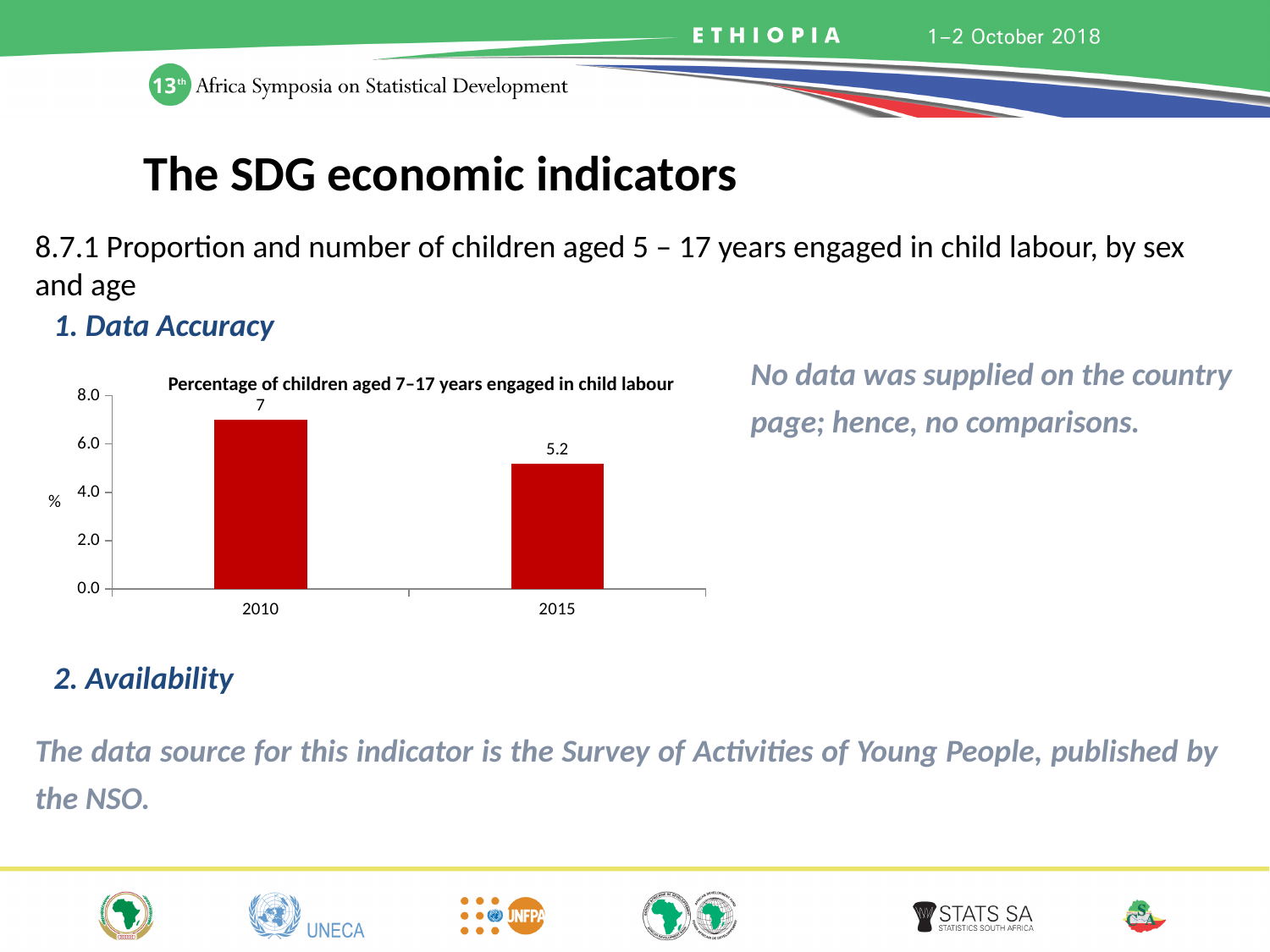
What is the value for 2015? 5.2 Is the value for 2010 greater or less than 6.0? greater Which year has the highest percentage of children engaged in child labour? 2010 Do the values rise or fall from 2010 to 2015? fall What is the title of the chart? Percentage of children aged 7–17 years engaged in child labour What is the difference between the values for 2010 and 2015? 1.8 Which is larger, the value for 2010 or the value for 2015? 2010 What is the value for 2010? 7 Is the value for 2015 greater or less than 6.0? less How many years are shown on the x axis? 2 What kind of chart is shown on the slide? bar chart Which year has the lowest percentage of children engaged in child labour? 2015